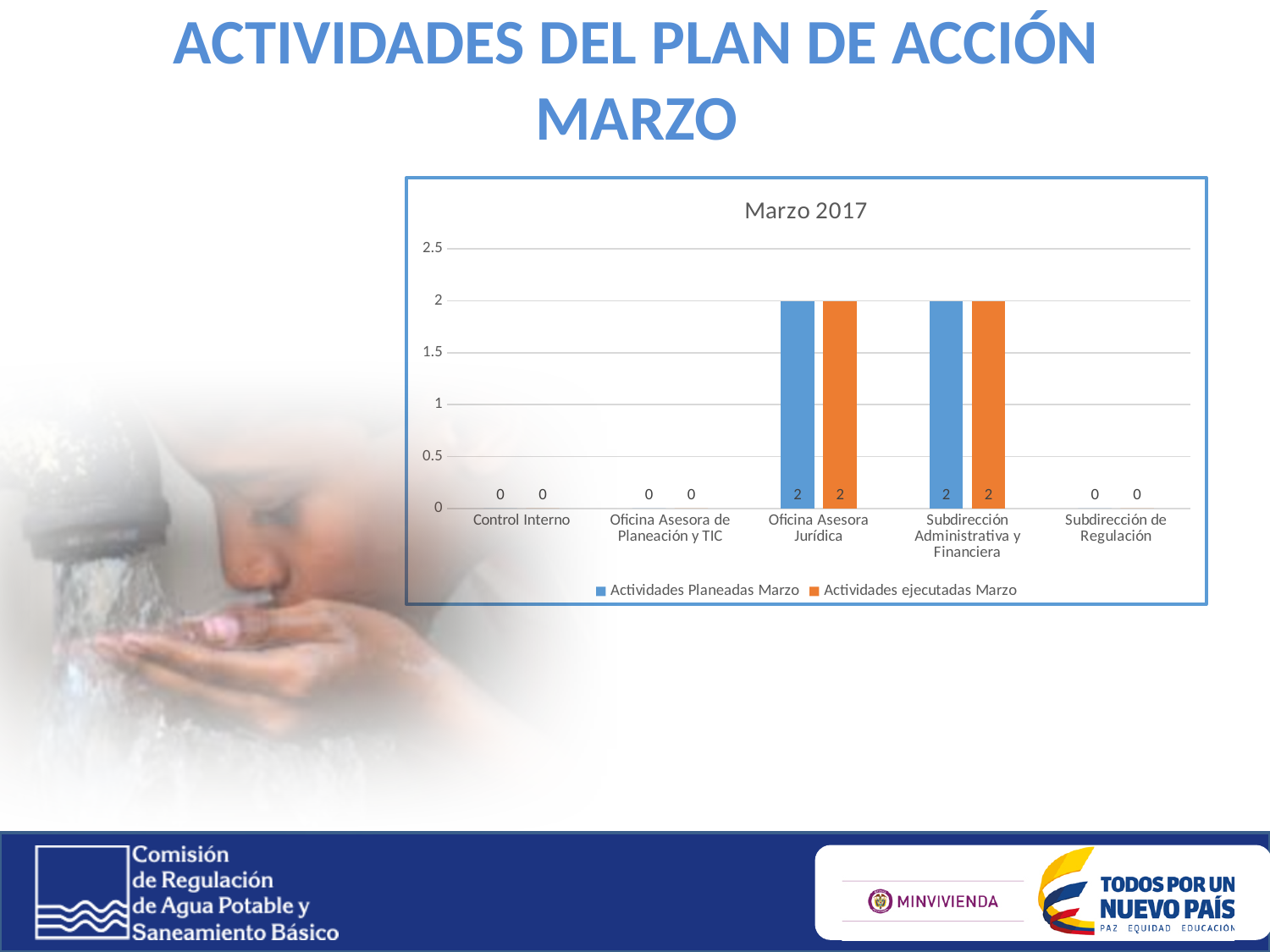
Which is larger for Actividades Planeadas Marzo: Oficina Asesora Jurídica or Oficina Asesora de Planeación y TIC? Oficina Asesora Jurídica What kind of chart is shown? bar chart Which colour represents Actividades ejecutadas Marzo in the legend? orange What is the value of Actividades Planeadas Marzo for Subdirección Administrativa y Financiera? 2 What is the value of Actividades ejecutadas Marzo for Subdirección de Regulación? 0 What is the title of the chart? Marzo 2017 What is the value of Actividades Planeadas Marzo for Oficina Asesora Jurídica? 2 How many series does the legend list? 2 Is the value of Actividades Planeadas Marzo for Subdirección Administrativa y Financiera greater or less than 1? greater What is the value of Actividades ejecutadas Marzo for Control Interno? 0 What is the difference between Actividades Planeadas Marzo and Actividades ejecutadas Marzo for Oficina Asesora Jurídica? 0 How many categories are shown on the x axis? 5